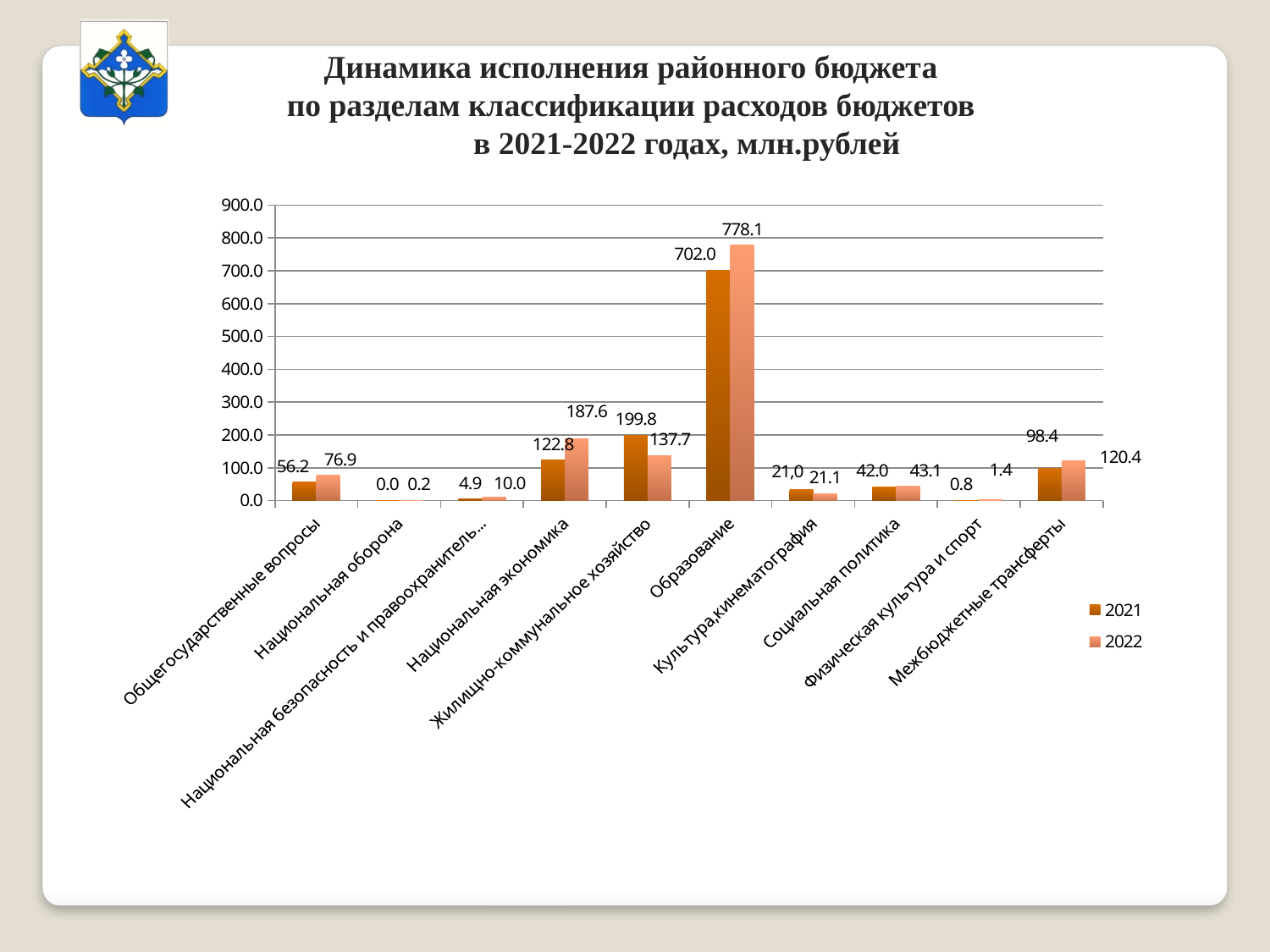
What is the 2022 value for Образование? 778.1 What kind of chart is shown on the slide? bar chart What is the 2021 value for Жилищно-коммунальное хозяйство? 199.8 Which is larger for Национальная экономика: the 2021 value or the 2022 value? 2022 How many series does the legend list? 2 How many categories are shown on the x axis? 10 What is the 2022 value for Межбюджетные трансферты? 120.4 Which category has the highest 2021 value? Образование What is the difference between the 2022 and 2021 values for Образование? 76.1 What is the difference between the 2021 and 2022 values for Жилищно-коммунальное хозяйство? 62.1 Which category has the lowest 2021 value? Национальная оборона Is the 2022 value for Общегосударственные вопросы greater or less than 100.0? less